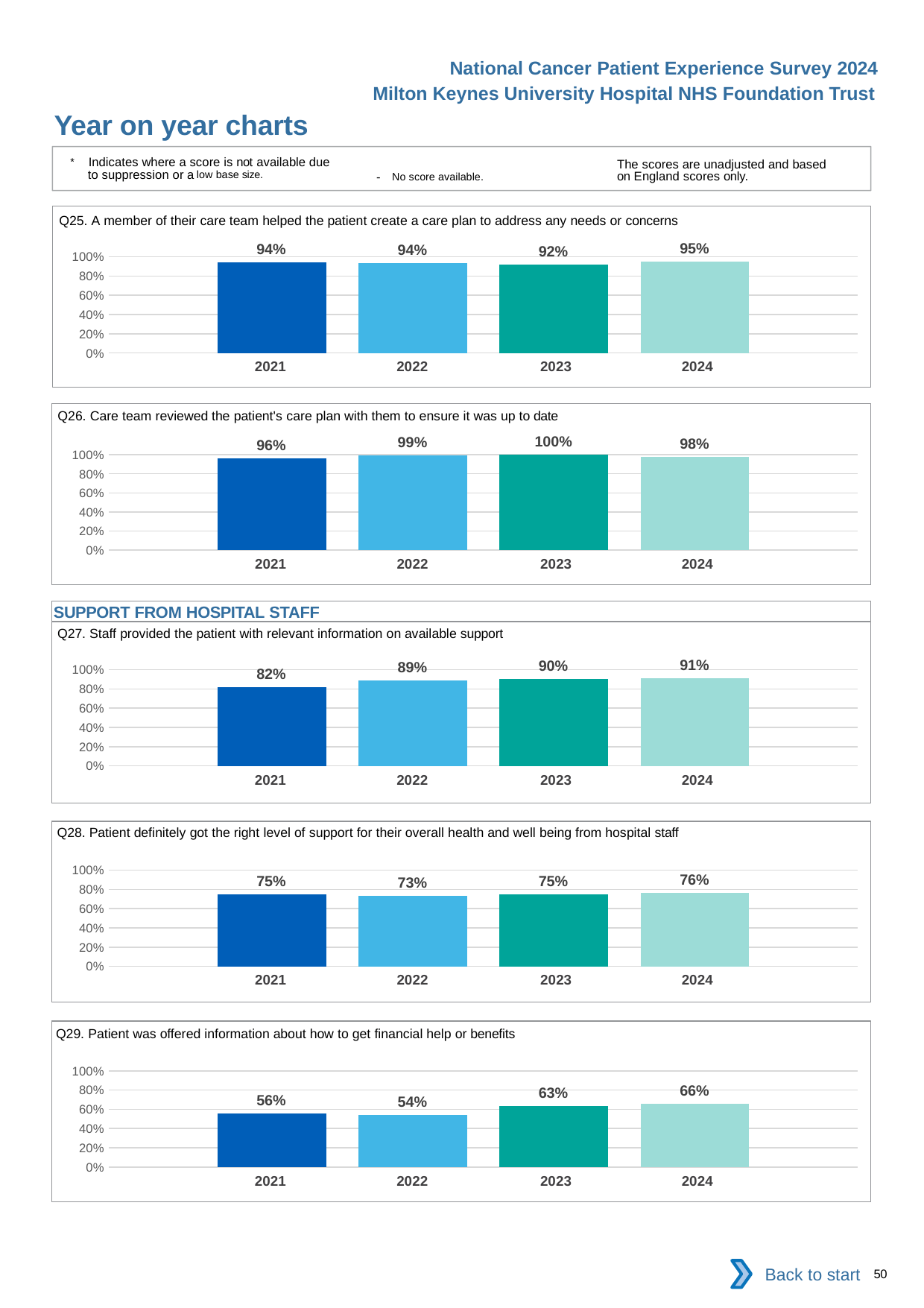
In the Q28 chart, which year has the lowest value? 2022 In the Q29 chart, is the value for 2022 greater or less than 60%? less In the Q27 chart, do the values rise or fall from 2021 to 2024? rise In the Q29 chart, what is the value for 2023? 63% In the Q29 chart, which is larger, the value for 2021 or the value for 2024? 2024 How many years are shown in the Q28 chart? 4 In the Q27 chart, what is the difference between the 2024 and 2021 values? 9% What kind of chart is the Q26 chart? bar chart In the Q26 chart, which year has the highest value? 2023 In the Q26 chart, what is the difference between the 2023 and 2021 values? 4% In the Q27 chart, what is the value for 2021? 82% In the Q25 chart, what is the value for 2024? 95%